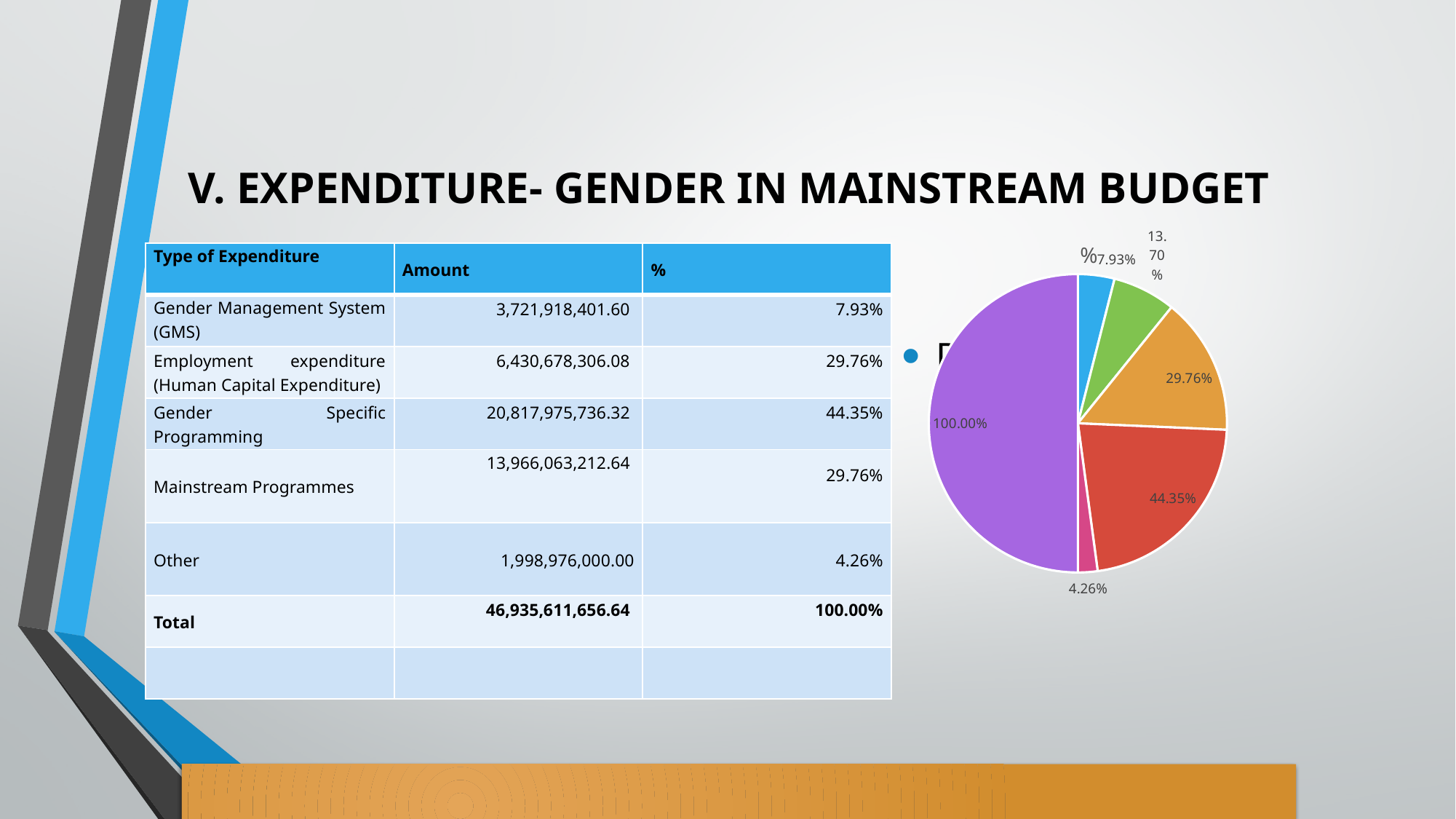
What value is labelled on the blue slice of the pie chart? 7.93% In the pie chart, which slice is larger, the red one or the orange one? the red one What value is labelled on the orange slice of the pie chart? 29.76% How many slices does the pie chart have? 6 What colour is the largest slice of the pie chart? purple In the pie chart, what is the difference between the red slice's label (44.35%) and the orange slice's label (29.76%)? 14.59% What value is labelled on the red slice of the pie chart? 44.35% What value is labelled on the green slice of the pie chart? 13.70% Does the pie chart display a legend? No What is the data label on the largest slice of the pie chart? 100.00% What is the data label on the smallest slice of the pie chart? 4.26% What kind of chart is shown on the right of the slide? pie chart